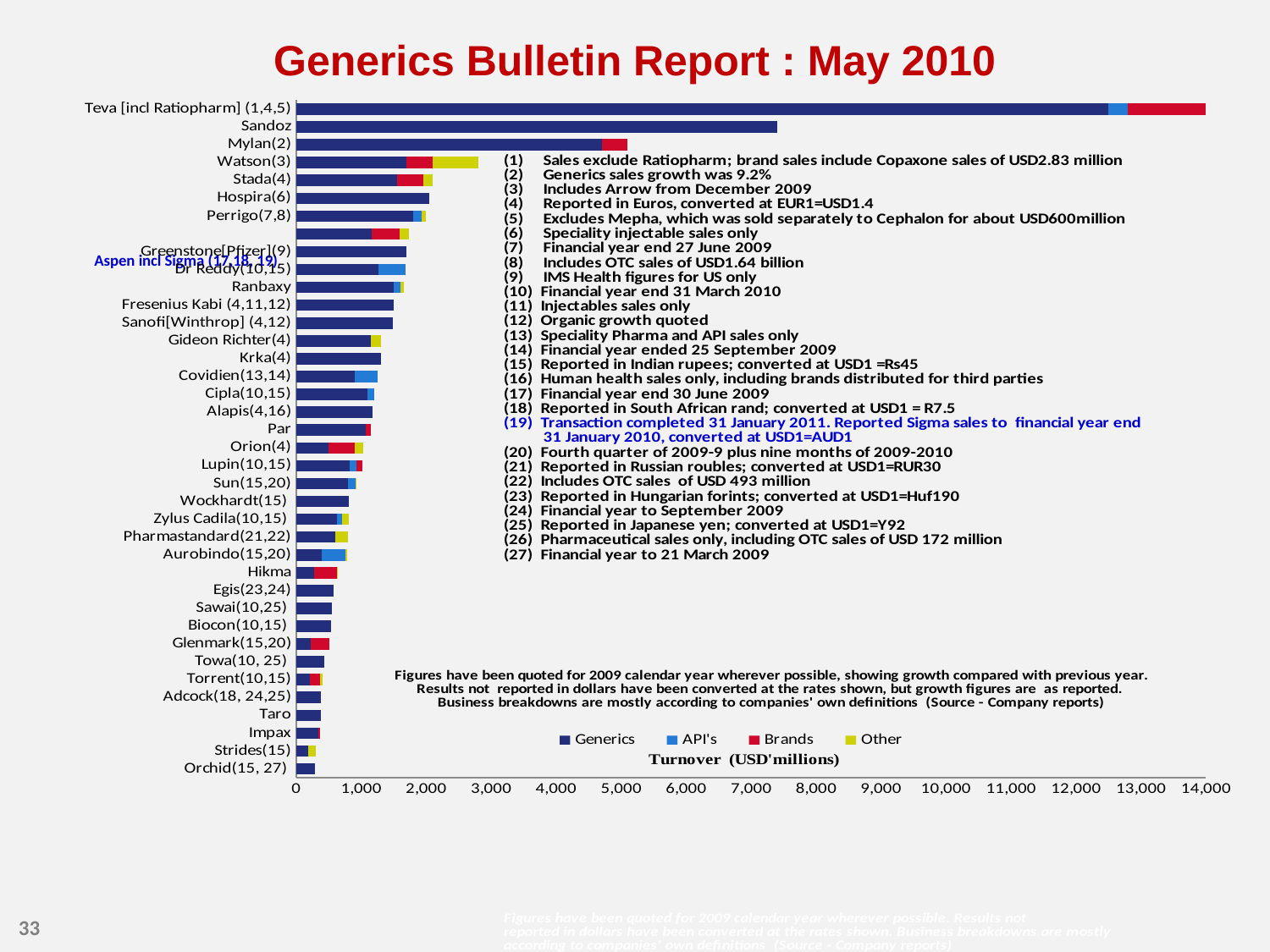
Do the total bar lengths rise or fall going down the list of companies from top to bottom? fall Is the total turnover for Sandoz greater or less than 7,000? greater Which company has the highest total turnover in the chart? Teva [incl Ratiopharm] (1,4,5) What is the title printed on the chart above the x axis? Turnover (USD'millions) Is the total turnover for Mylan(2) greater or less than 6,000? less How many series does the chart legend list? 4 What kind of chart is shown on the slide? bar chart Is the total turnover for Teva [incl Ratiopharm] greater or less than 13,000? greater Which has the larger total turnover, Sandoz or Mylan(2)? Sandoz Which has the larger total turnover, Watson(3) or Stada(4)? Watson(3)